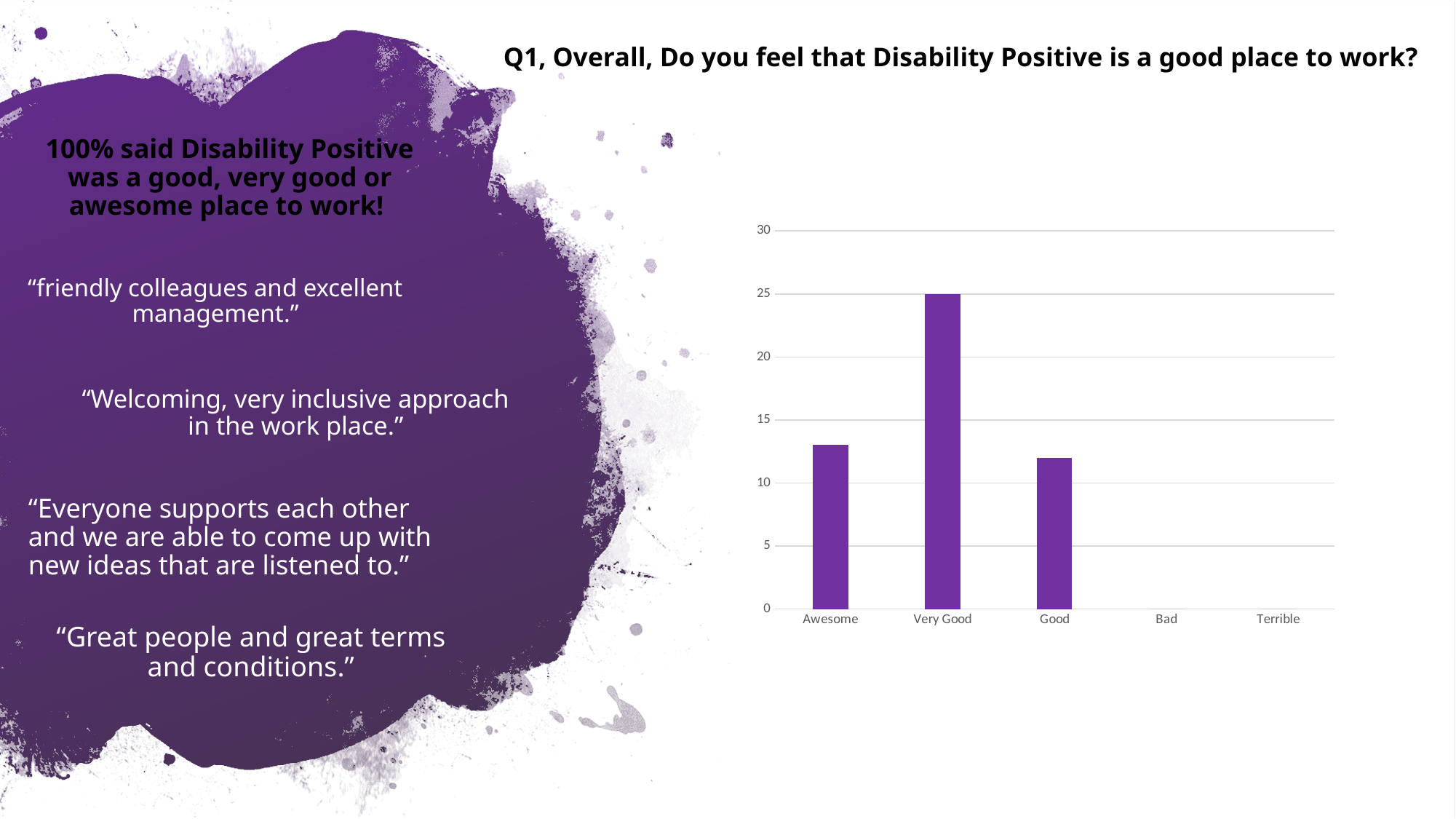
What kind of chart is shown on the slide? Bar chart Is the value for Awesome greater or less than 10? greater How many categories are shown on the x axis of the chart? 5 What is the title of the chart? Q1, Overall, Do you feel that Disability Positive is a good place to work? What is the value for Very Good in the chart? 25 Which category has the highest value in the chart? Very Good What colour are the bars in the chart? Purple What is the value for Terrible in the chart? 0 Is the value for Good greater or less than 15? less Which is larger, the value for Very Good or the value for Awesome? Very Good Is the value for Awesome greater or less than 15? less What is the value for Bad in the chart? 0